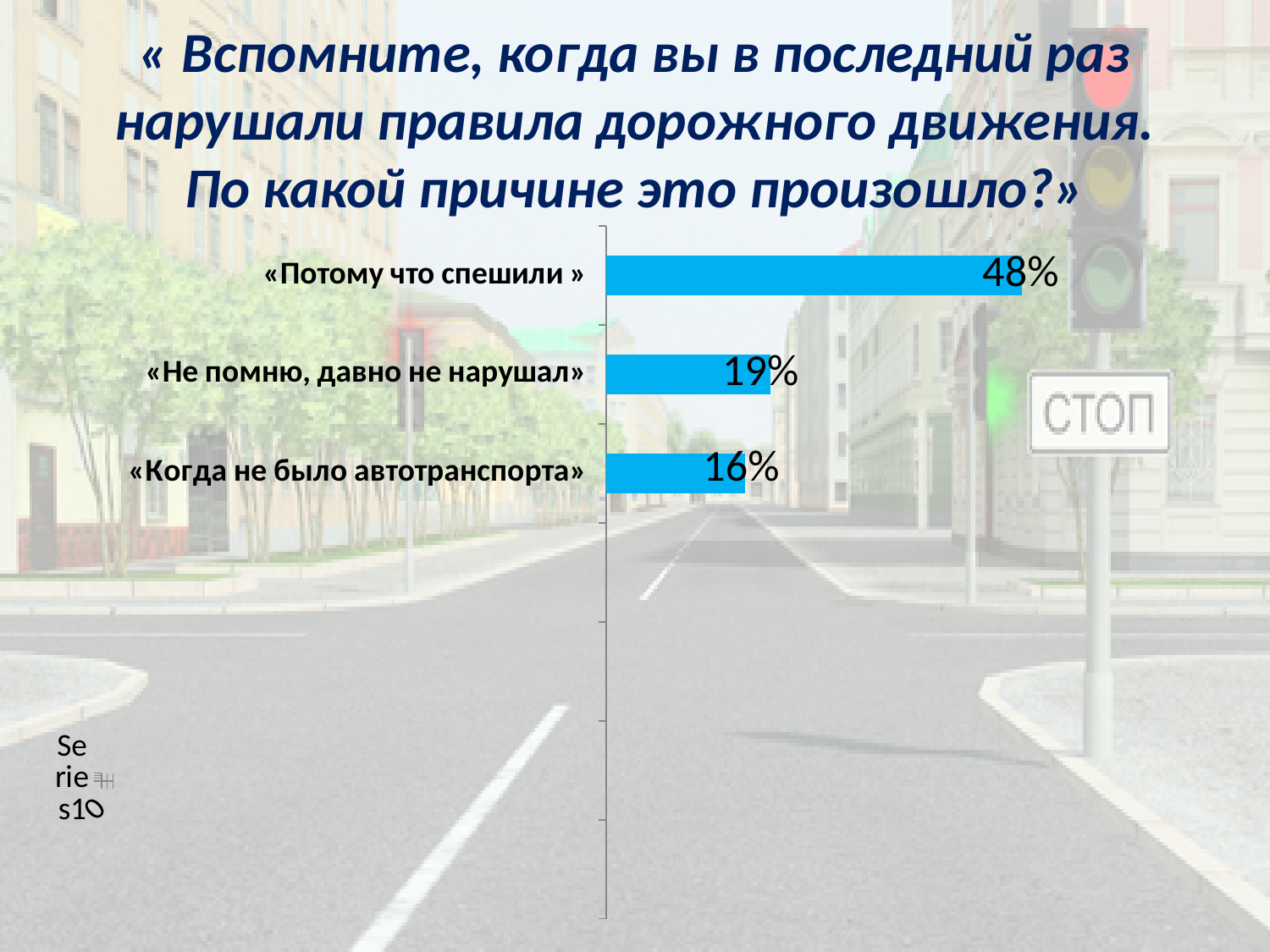
What is the difference between the values for «Не помню, давно не нарушал» and «Когда не было автотранспорта»? 3% What percentage of respondents answered «Потому что спешили»? 48% What is the total of the three labelled values in the chart? 83% What colour are the bars in the chart? Blue Which answer option has the lowest value? «Когда не было автотранспорта» How many bars with data labels are shown in the chart? 3 Which is larger: the value for «Потому что спешили» or for «Когда не было автотранспорта»? «Потому что спешили» What kind of chart is shown on the slide? Bar chart What value is shown for «Когда не было автотранспорта»? 16% What value is shown for «Не помню, давно не нарушал»? 19% Which answer option has the highest value? «Потому что спешили» What is the difference between the values for «Потому что спешили» and «Не помню, давно не нарушал»? 29%